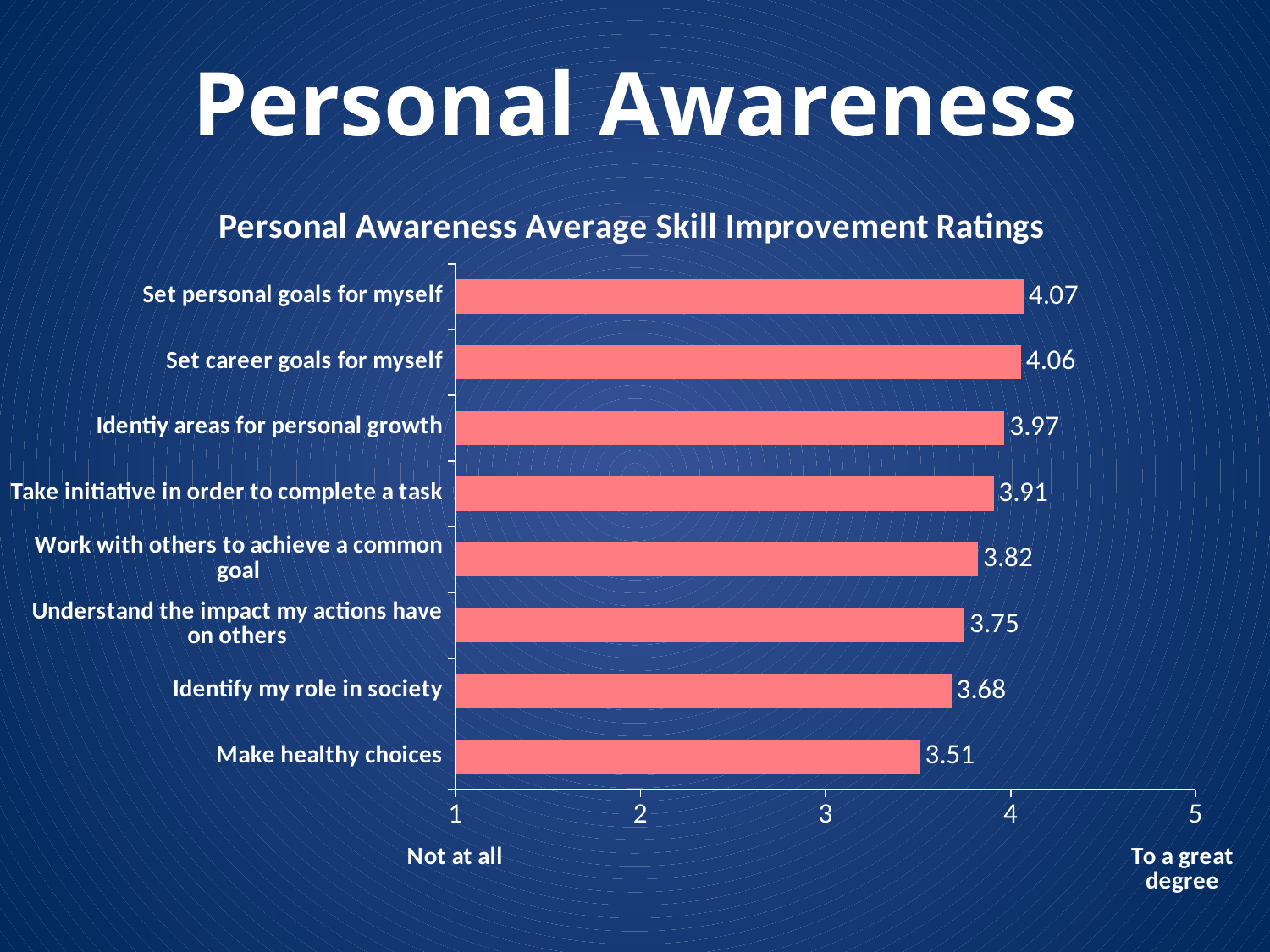
Which skill has the lowest average improvement rating? Make healthy choices What is the title of the chart? Personal Awareness Average Skill Improvement Ratings What type of chart is shown on the slide? Bar chart What is the rating for "Work with others to achieve a common goal"? 3.82 What is the difference between the ratings for "Set personal goals for myself" and "Make healthy choices"? 0.56 What is the rating for "Make healthy choices"? 3.51 Which has a higher rating: "Identify my role in society" or "Understand the impact my actions have on others"? Understand the impact my actions have on others How many skills are shown in the chart? 8 Which skill has the highest average improvement rating? Set personal goals for myself Is the rating for "Take initiative in order to complete a task" greater or less than 4? less What is the average skill improvement rating for "Set personal goals for myself"? 4.07 What label appears under the value 5 on the axis? To a great degree